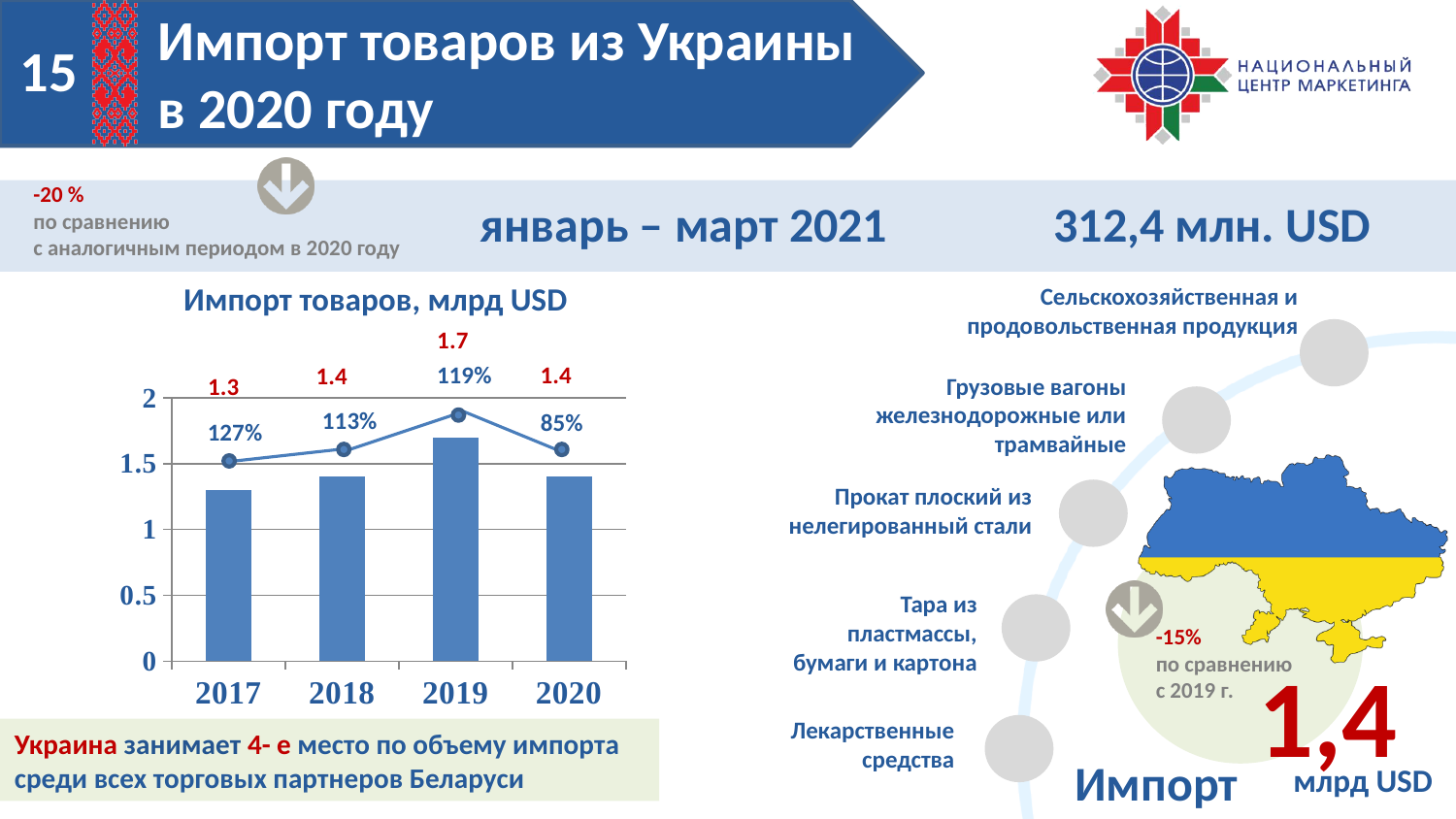
Which year has the highest bar in the chart? 2019 What is the import value shown for 2019 in the chart 'Импорт товаров, млрд USD'? 1.7 Which is larger, the bar value for 2019 or for 2020? 2019 What is the import value shown for 2017 in the chart? 1.3 Which year has the lowest bar in the chart? 2017 What kind of chart is shown on the slide? Combined bar and line chart What is the difference between the bar values for 2019 and 2017? 0.4 What percentage is shown on the line for 2020? 85% How many years are shown on the x axis of the chart? 4 What is the title of the chart on the slide? Импорт товаров, млрд USD Do the bar values rise or fall from 2019 to 2020? Fall What percentage is shown on the line for 2017? 127%